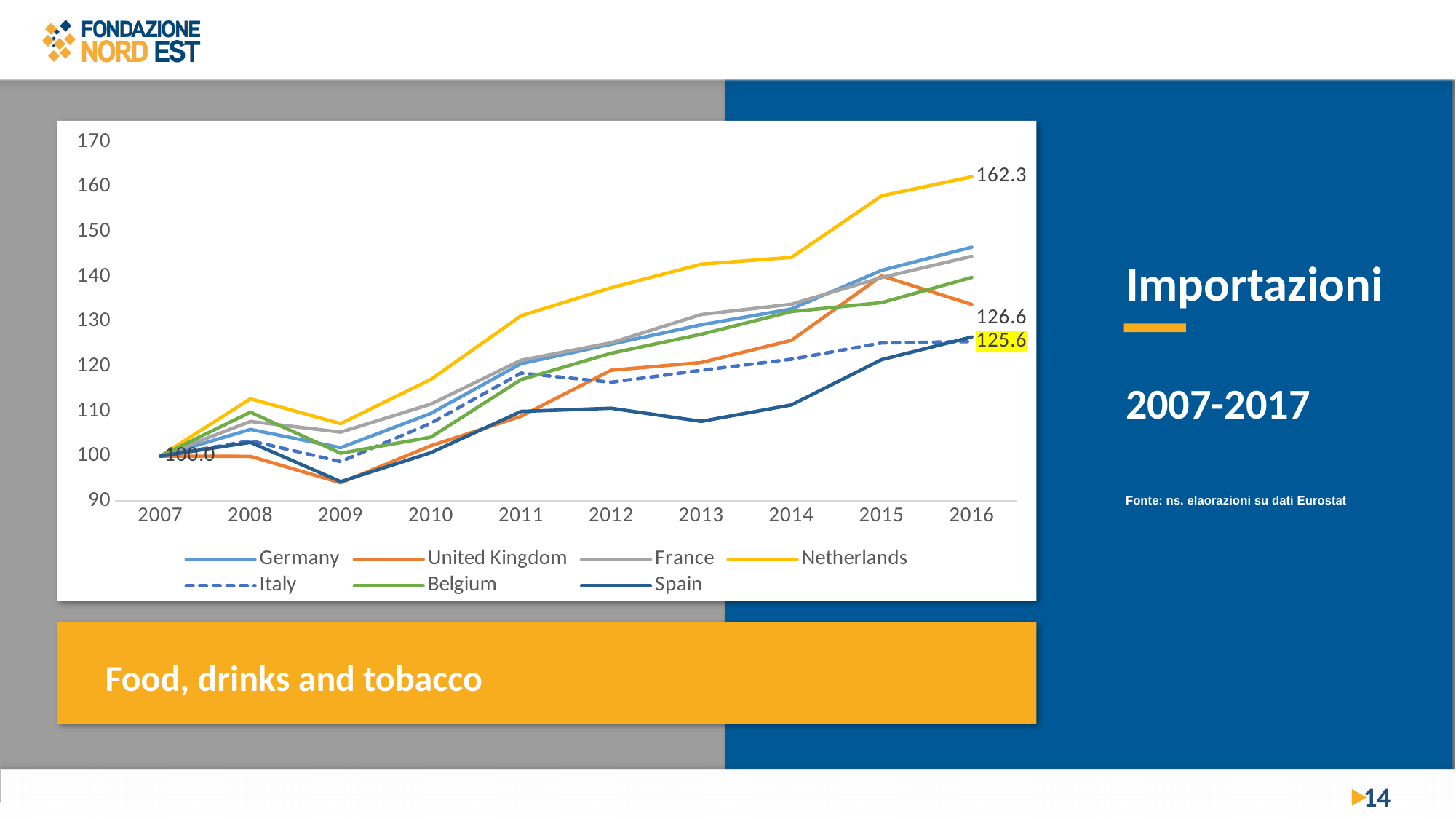
Which country has the highest value in 2016? Netherlands What is the value for the Netherlands in 2016? 162.3 Which series is drawn with a dashed line? Italy How many series does the legend list? 7 What is the value for Italy in 2016? 125.6 Is the value for Spain in 2009 greater or less than 100? less What kind of chart is shown on the slide? line chart How many years are shown on the x axis? 10 Is the value for Germany in 2016 greater or less than 140? greater Does the Netherlands line rise or fall from 2009 to 2016? rise